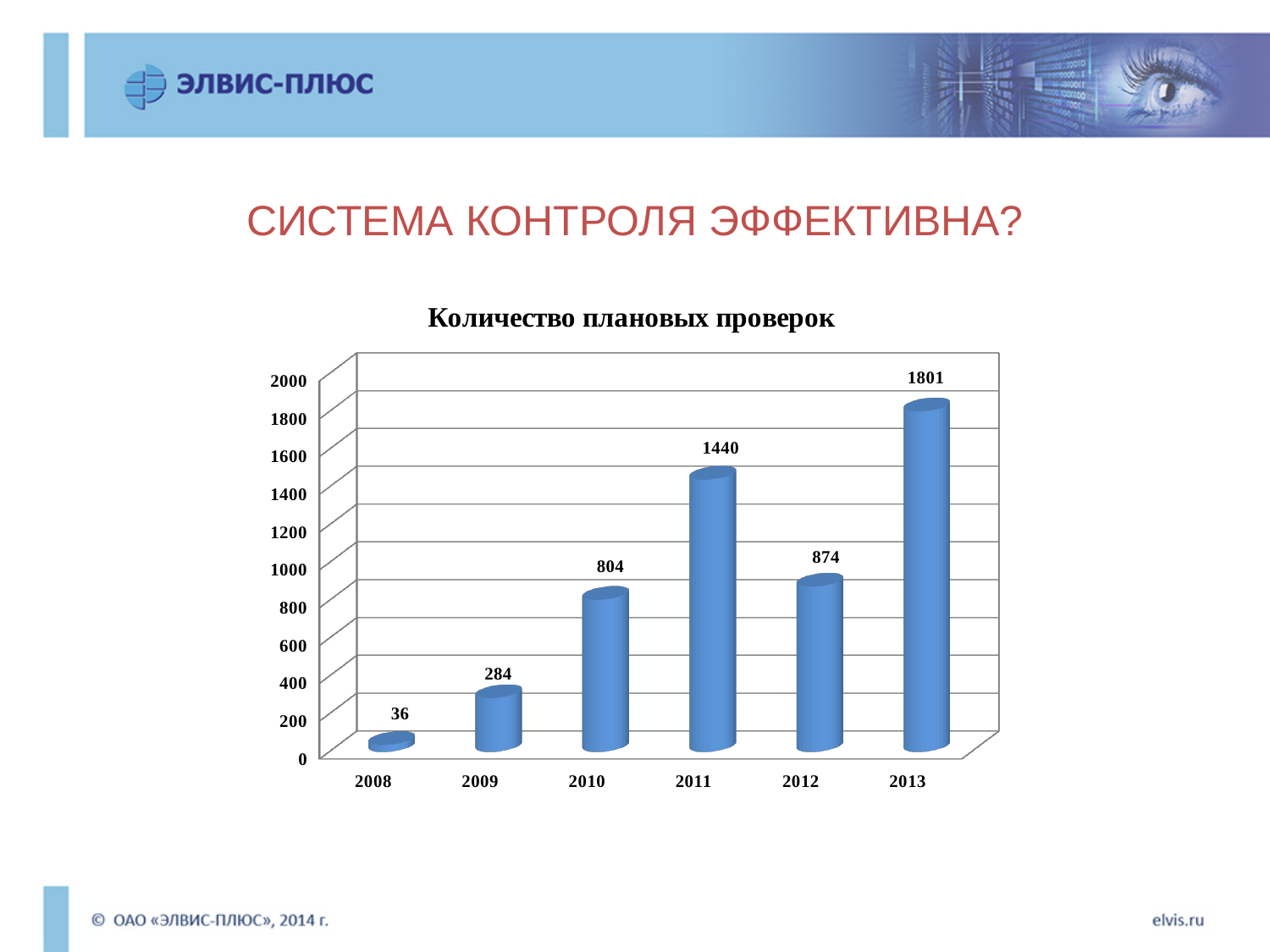
What is the value for 2012? 874 What is the difference between the values for 2013 and 2011? 361 What kind of chart is this? bar chart What is the value for 2008? 36 Which is larger, the value for 2011 or the value for 2012? 2011 How many years are shown on the x axis? 6 Which year has the highest value? 2013 What is the value for 2011? 1440 Does the value rise or fall from 2011 to 2012? fall What is the difference between the values for 2010 and 2009? 520 Which year has the lowest value? 2008 What is the title of the chart? Количество плановых проверок